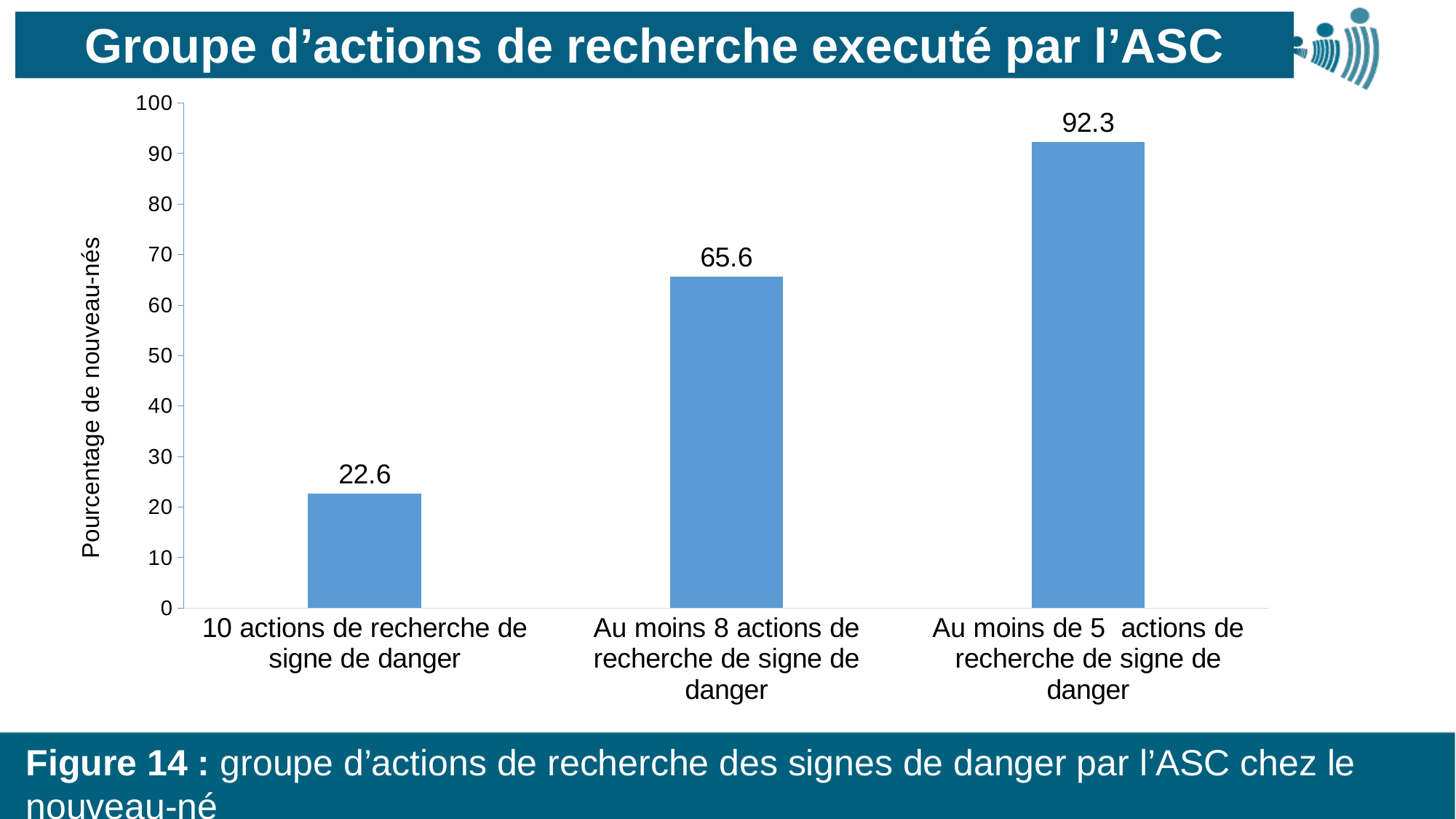
What is the value for "Au moins de 5 actions de recherche de signe de danger"? 92.3 Which category has the lowest value? 10 actions de recherche de signe de danger What is the value for "10 actions de recherche de signe de danger"? 22.6 What is the value for "Au moins 8 actions de recherche de signe de danger"? 65.6 What is the label of the vertical axis? Pourcentage de nouveau-nés How many categories are shown on the chart? 3 What is the difference between the values for "Au moins de 5 actions" and "Au moins 8 actions"? 26.7 Is the value for "Au moins de 5 actions de recherche de signe de danger" greater or less than 90? greater What kind of chart is shown on the slide? bar chart Which is larger: the value for "10 actions de recherche de signe de danger" or for "Au moins 8 actions de recherche de signe de danger"? Au moins 8 actions de recherche de signe de danger Which category has the highest value? Au moins de 5 actions de recherche de signe de danger What is the difference between the values for "Au moins 8 actions" and "10 actions"? 43